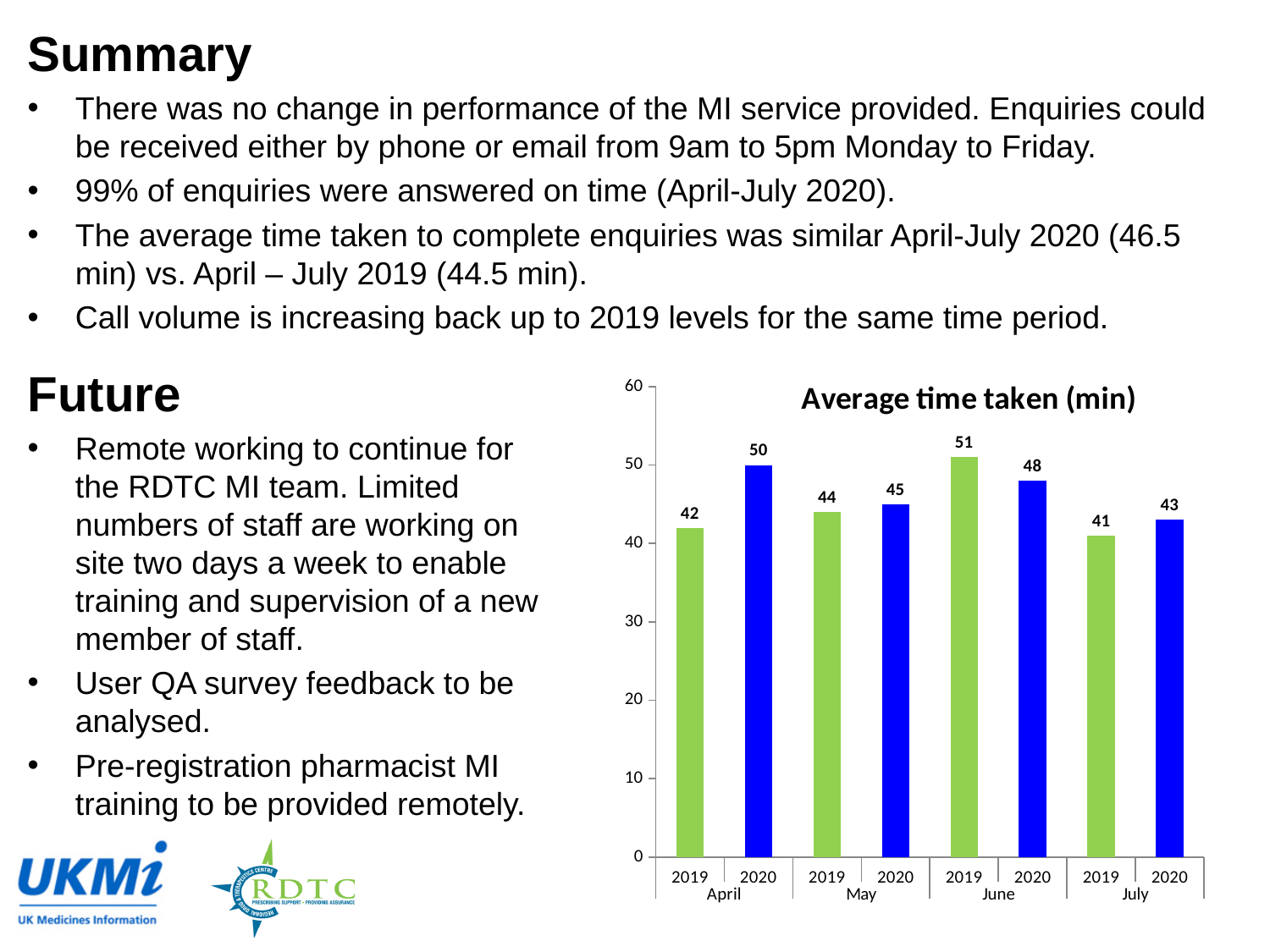
Which month and year has the highest average time taken? June 2019 Which month and year has the lowest average time taken? July 2019 What colour are the bars for 2020? blue What type of chart is shown on the slide? bar chart What is the title of the chart? Average time taken (min) What is the average time taken in minutes for July 2019? 41 Which is larger, the average time taken for May 2019 or May 2020? May 2020 Is the average time taken for June 2020 greater or less than 40? greater What is the difference in average time taken between April 2020 and April 2019? 8 What is the average time taken in minutes for April 2020? 50 How many bars are plotted in the chart? 8 What is the average time taken in minutes for June 2019? 51